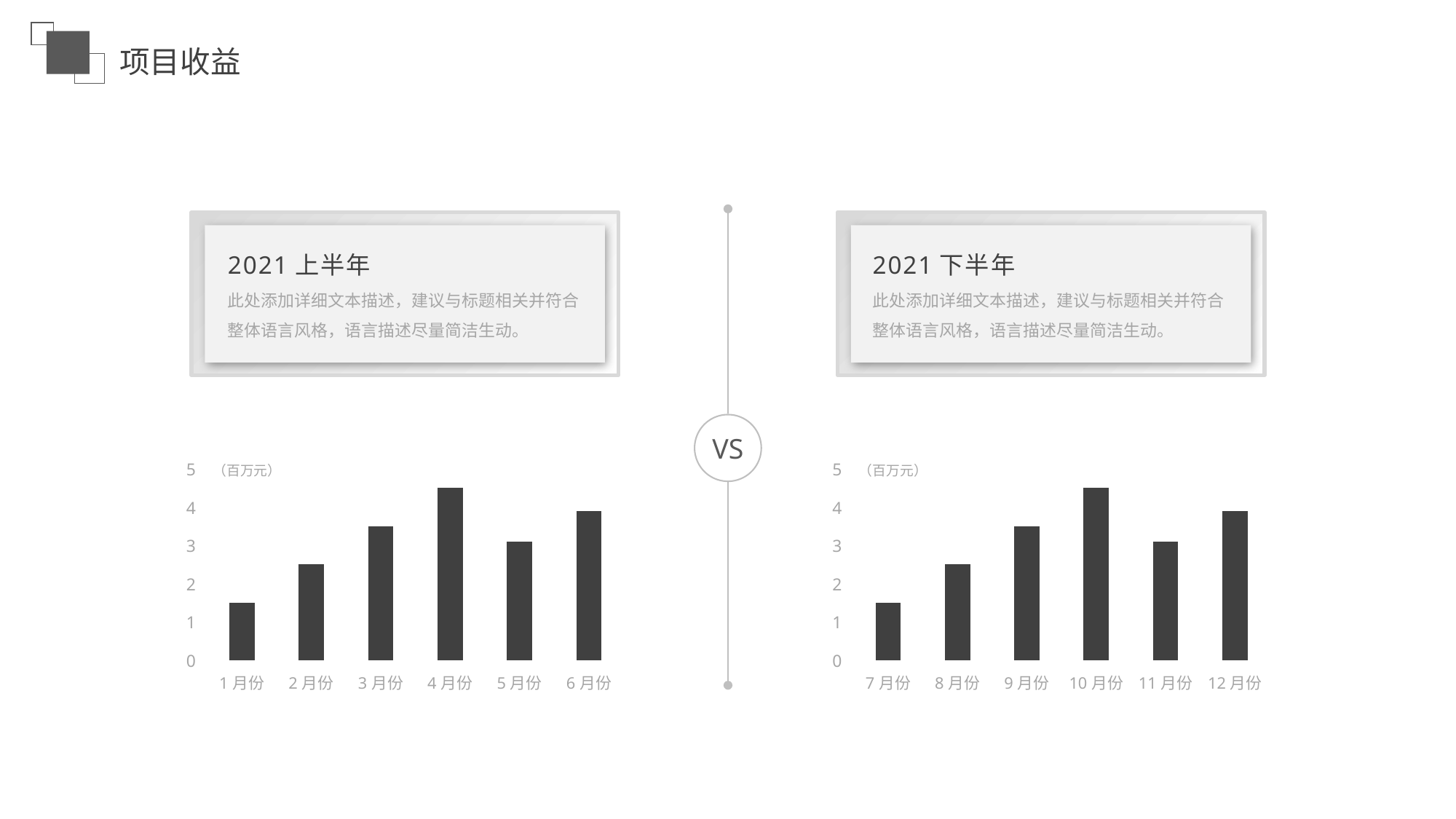
On the left chart (2021 上半年), which month has the highest bar? 4 月份 On the right chart (2021 下半年), which month has the highest bar? 10 月份 On the right chart (2021 下半年), which month has the lowest bar? 7 月份 On the left chart (2021 上半年), is the value for 1 月份 greater or less than 2? less On the left chart (2021 上半年), which month has the lowest bar? 1 月份 On the right chart (2021 下半年), is the value for 9 月份 greater or less than 3? greater On the left chart (2021 上半年), which is larger, the value for 3 月份 or the value for 5 月份? 3 月份 On the right chart (2021 下半年), which is larger, the value for 11 月份 or the value for 12 月份? 12 月份 What type of chart is used for 2021 下半年 on the right? Bar chart On the left chart (2021 上半年), is the value for 4 月份 greater or less than 4? greater How many months are shown on the left chart (2021 上半年)? 6